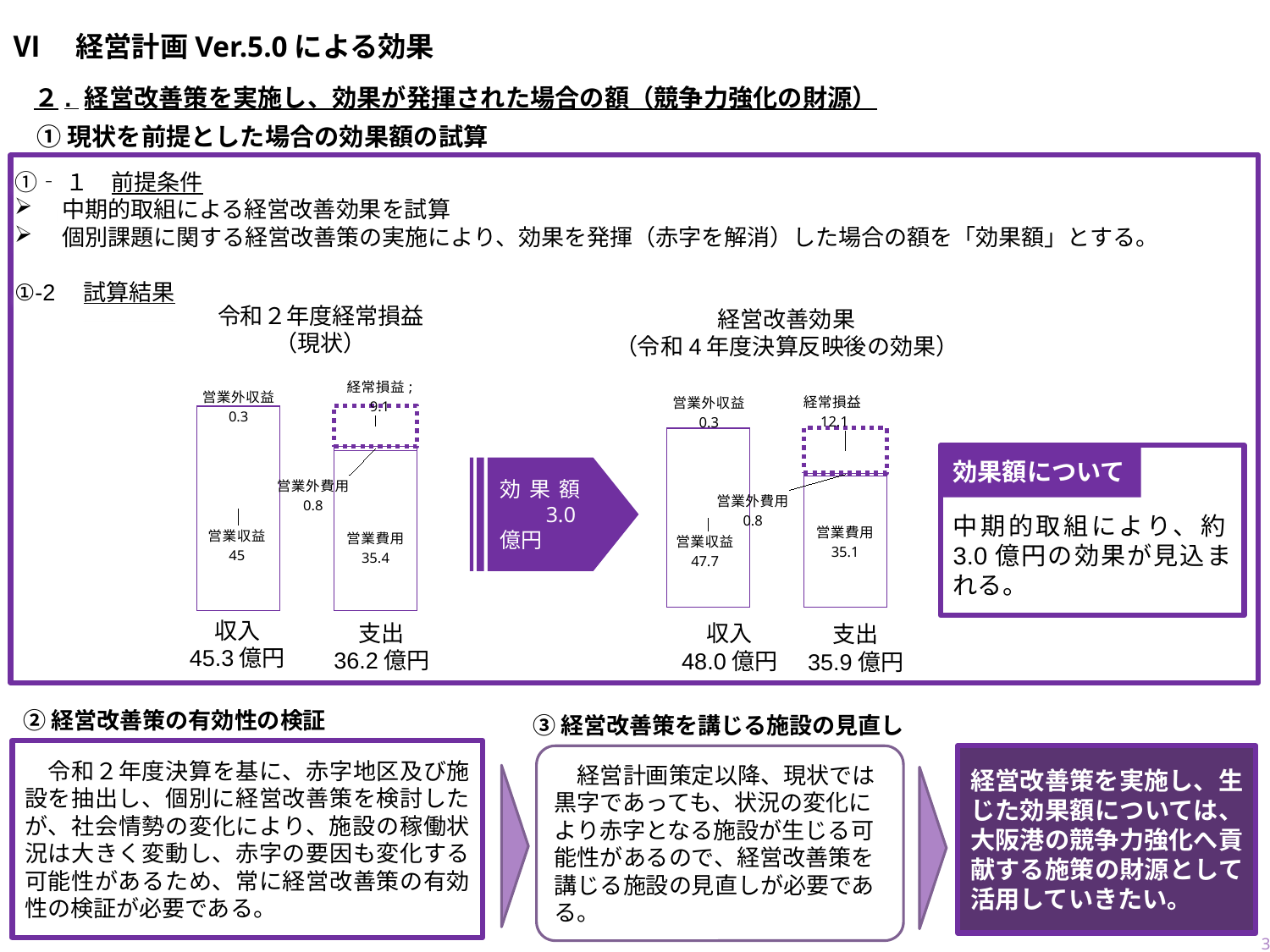
What is the 効果額 shown in the arrow between the two charts? 3.0 億円 In the left chart (令和２年度経常損益（現状）), what is the value of 営業収益? 45 In the left chart (令和２年度経常損益（現状）), what is the total shown for 収入? 45.3 億円 In the left chart (令和２年度経常損益（現状）), what is the total shown for 支出? 36.2 億円 What is the difference between 営業収益 in the right chart (47.7) and 営業収益 in the left chart (45)? 2.7 In the right chart (経営改善効果), what is the value of 営業収益? 47.7 What kind of chart is used to show 収入 and 支出 on this slide? Stacked bar chart Which is larger: 営業費用 in the left chart or 営業費用 in the right chart? Left chart (35.4) In the right chart (経営改善効果), what is the total shown for 収入? 48.0 億円 In the left chart (令和２年度経常損益（現状）), what is the value of 営業費用? 35.4 In the right chart (経営改善効果), what is the value of 経常損益? 12.1